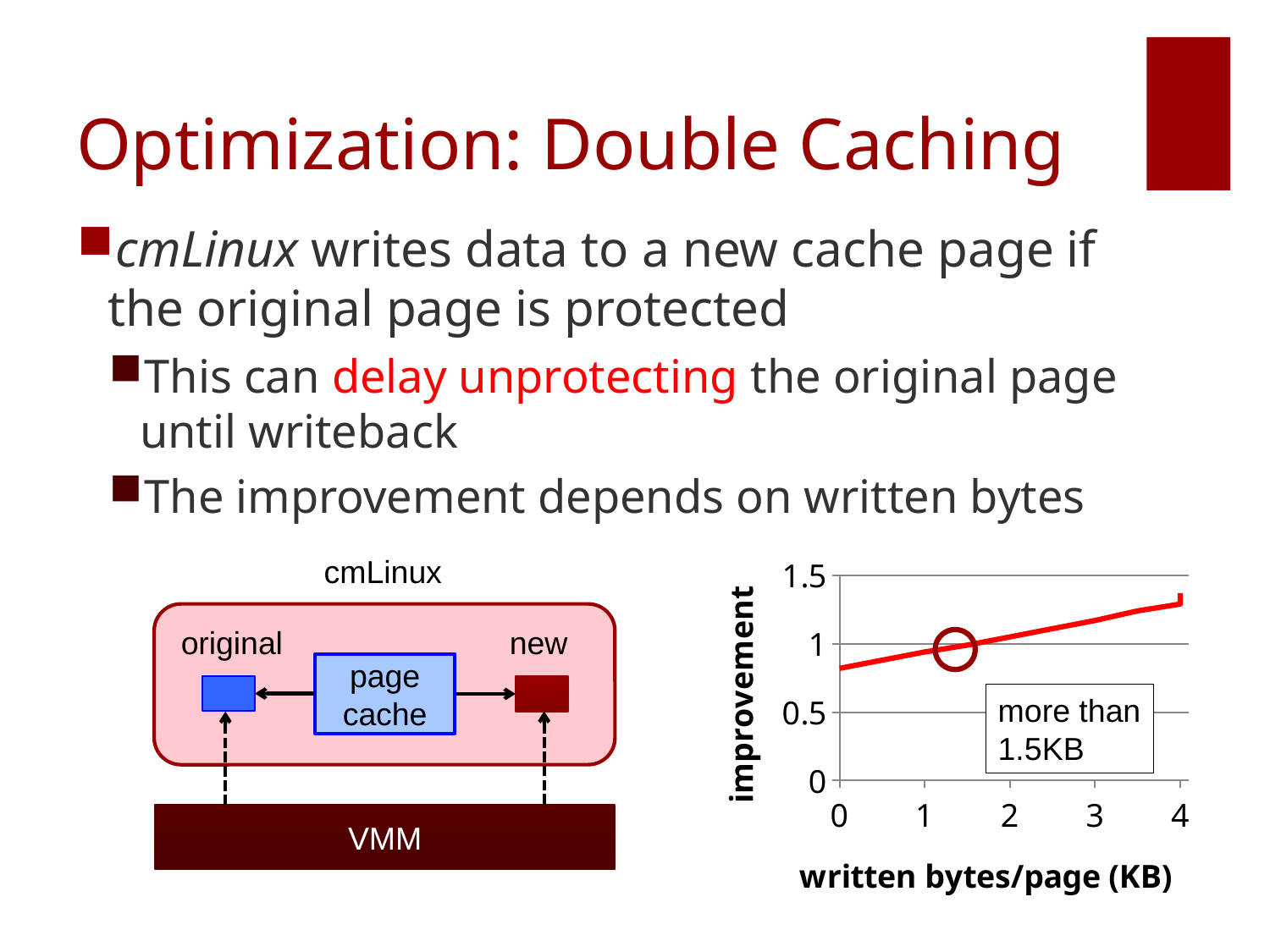
Is the improvement at 0 KB written bytes/page greater or less than 1? less Is the improvement at 4 KB written bytes/page greater or less than 1? greater Is the improvement at 3 KB written bytes/page greater or less than 1? greater What text appears in the annotation box inside the chart? more than 1.5KB What is the label of the x axis of the chart? written bytes/page (KB) What kind of chart is shown on the slide? line chart Does the improvement rise or fall as written bytes/page increases? rise Which is larger, the improvement at 1 KB or at 3 KB written bytes/page? 3 KB